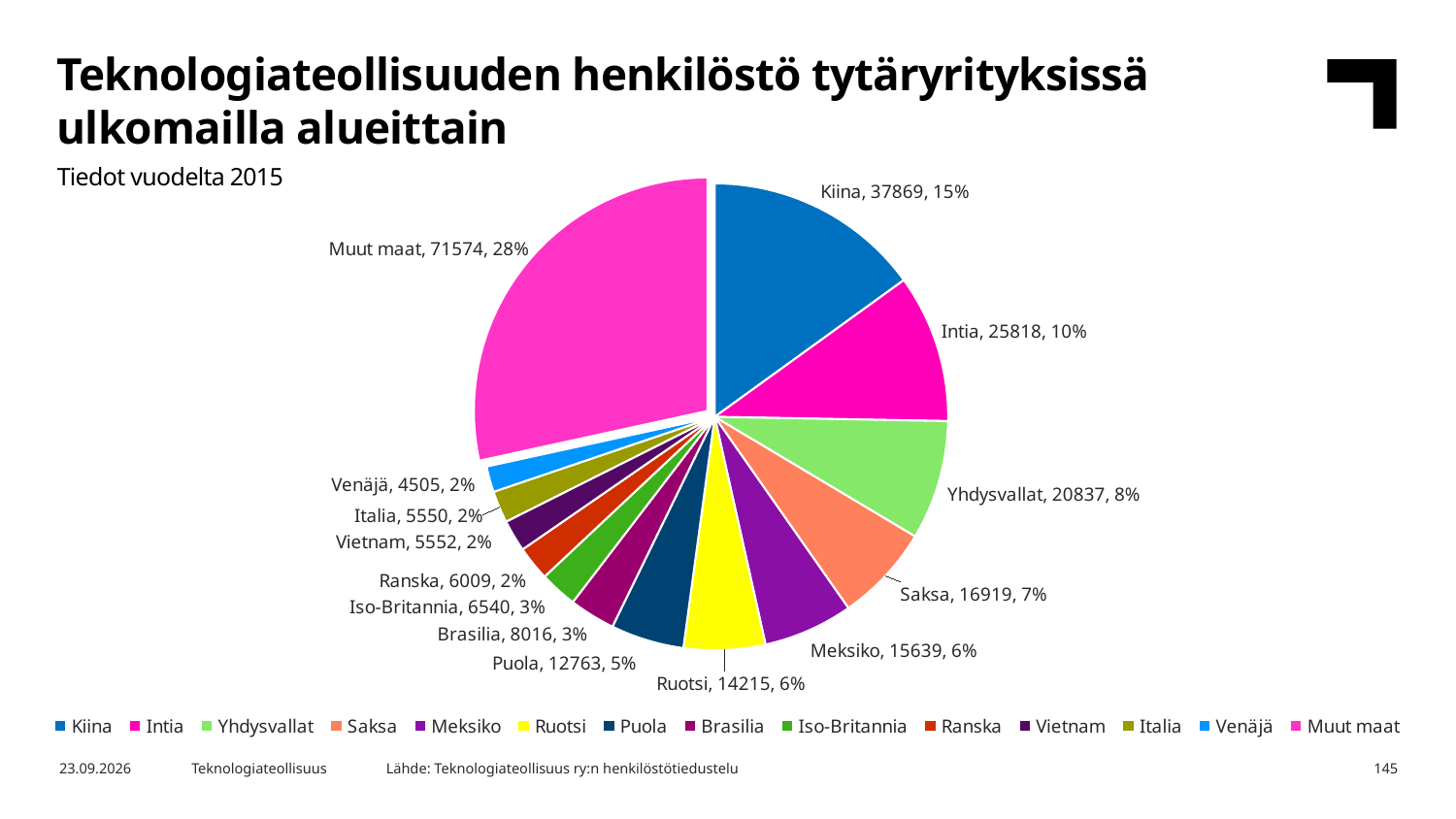
Which is larger, the value for Meksiko or the value for Ruotsi? Meksiko What is the value for Puola? 12763 What kind of chart is shown on the slide? Pie chart What share of the pie does Intia represent? 10% What share of the pie does Muut maat represent? 28% What is the title of the chart on the slide? Teknologiateollisuuden henkilöstö tytäryrityksissä ulkomailla alueittain What is the difference between the values for Kiina and Intia? 12051 Which slice is the smallest in the pie chart? Venäjä What is the value for Kiina? 37869 Which slice is the largest in the pie chart? Muut maat How many slices does the pie chart have? 14 What is the value for Saksa? 16919